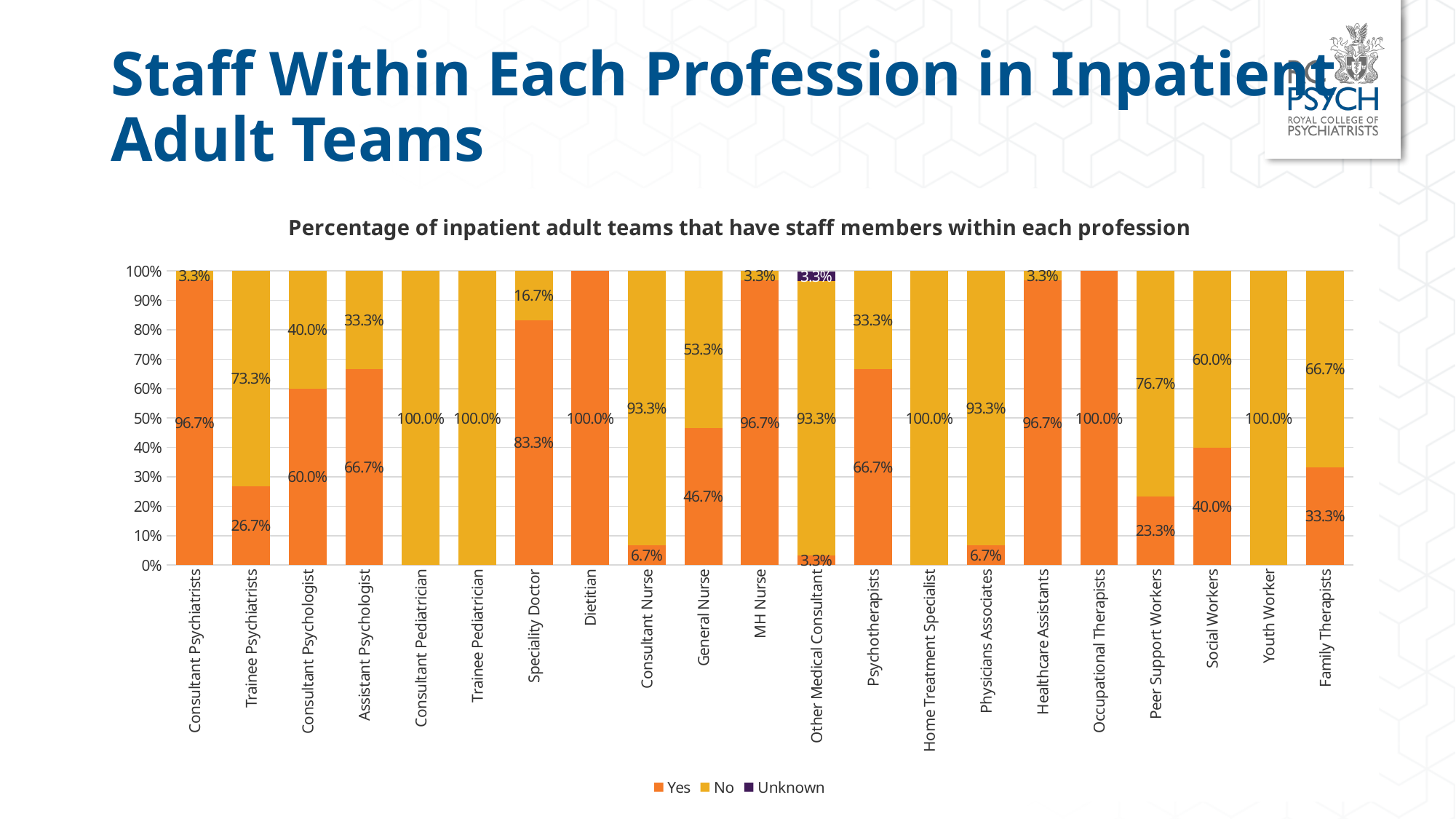
Which profession has the lowest "Yes" percentage among those with a non-zero "Yes" value? Other Medical Consultant What kind of chart is shown on the slide? Stacked bar chart How many series does the legend list? 3 What is the difference between the "Yes" percentages for Consultant Psychologist and Social Workers? 20.0% What is the "Yes" percentage for Speciality Doctor? 83.3% Which series is shown in purple in the legend? Unknown What is the "Yes" percentage for Trainee Psychiatrists? 26.7% How many professions are shown on the x axis? 21 Which has a larger "Yes" percentage, Psychotherapists or Family Therapists? Psychotherapists What is the "No" percentage for General Nurse? 53.3% What is the "Unknown" percentage for Other Medical Consultant? 3.3% What is the "No" percentage for Peer Support Workers? 76.7%